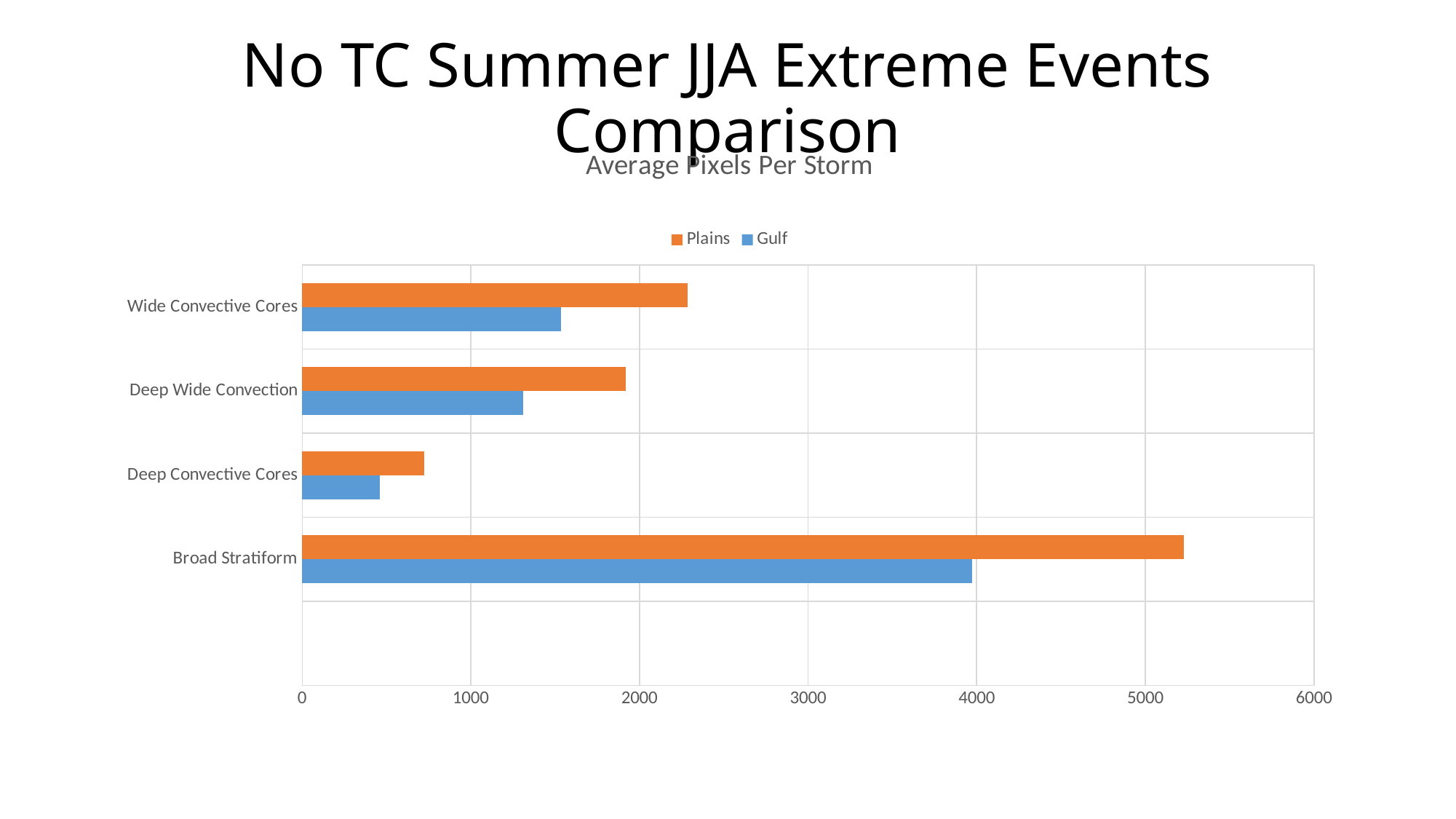
How many categories are shown on the chart? 4 Is the Plains value for Broad Stratiform greater or less than 5000? greater Is the Gulf value for Broad Stratiform greater or less than 3000? greater For Deep Wide Convection, which series has the larger value, Plains or Gulf? Plains Which category has the highest Plains value? Broad Stratiform How many series does the legend list? 2 Which category has the lowest Gulf value? Deep Convective Cores Which is larger: the Gulf value for Wide Convective Cores or the Gulf value for Deep Wide Convection? Wide Convective Cores Is the Gulf value for Wide Convective Cores greater or less than 1000? greater What kind of chart is shown on the slide? bar chart What is the title of the chart? Average Pixels Per Storm